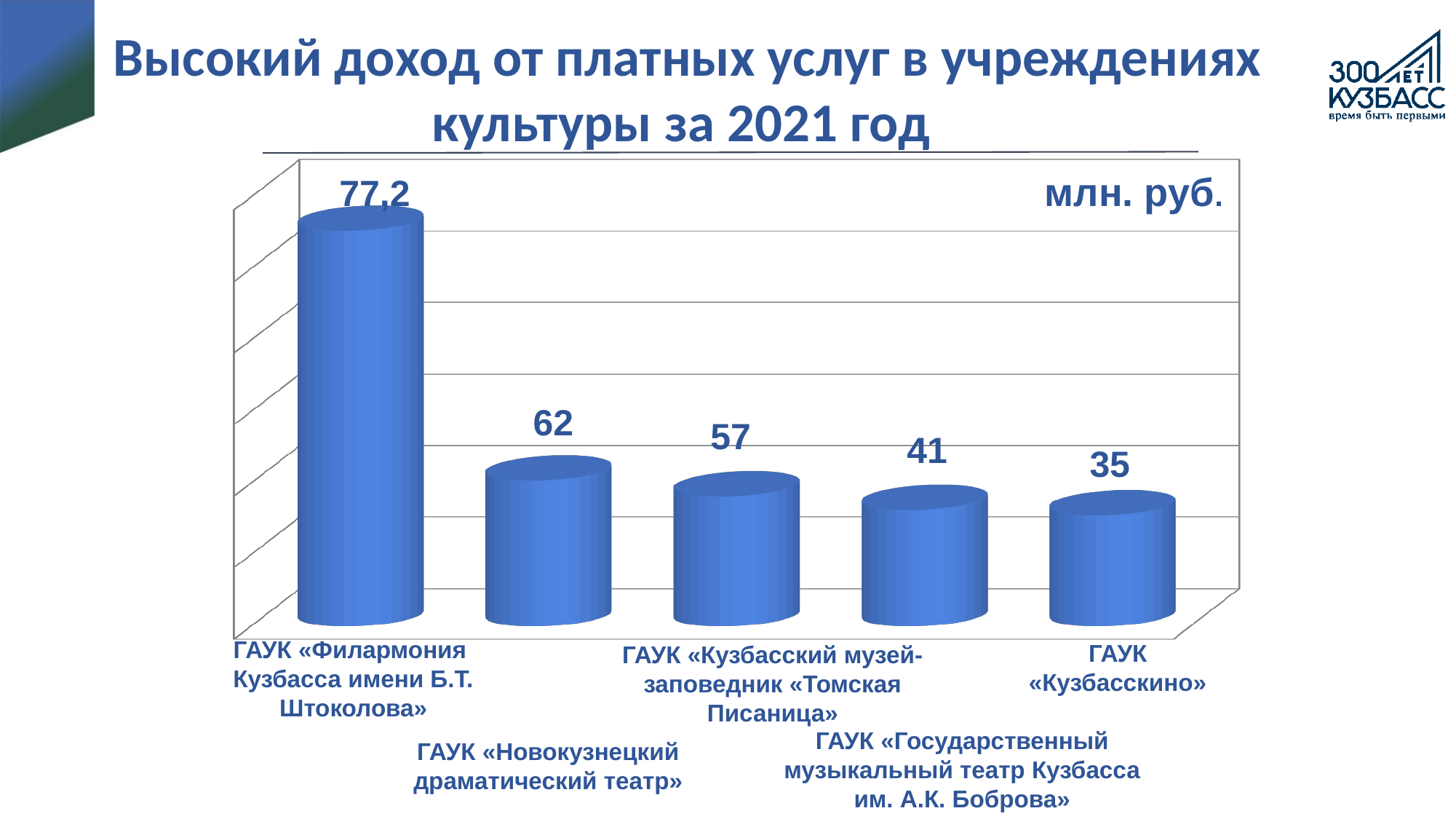
How many institutions are shown in the chart? 5 Which is larger, the value for ГАУК «Кузбасский музей-заповедник «Томская Писаница» or for ГАУК «Государственный музыкальный театр Кузбасса им. А.К. Боброва»? ГАУК «Кузбасский музей-заповедник «Томская Писаница» What unit is indicated for the values in the chart? млн. руб. What is the value for ГАУК «Государственный музыкальный театр Кузбасса им. А.К. Боброва»? 41 Which institution has the highest income from paid services? ГАУК «Филармония Кузбасса имени Б.Т. Штоколова» What kind of chart is shown on the slide? Bar chart What is the value for ГАУК «Кузбасский музей-заповедник «Томская Писаница»? 57 What is the value for ГАУК «Новокузнецкий драматический театр»? 62 What is the value for ГАУК «Филармония Кузбасса имени Б.Т. Штоколова»? 77,2 What is the value for ГАУК «Кузбасскино»? 35 Which institution has the lowest income from paid services? ГАУК «Кузбасскино» What is the difference between the values for ГАУК «Новокузнецкий драматический театр» and ГАУК «Кузбасскино»? 27